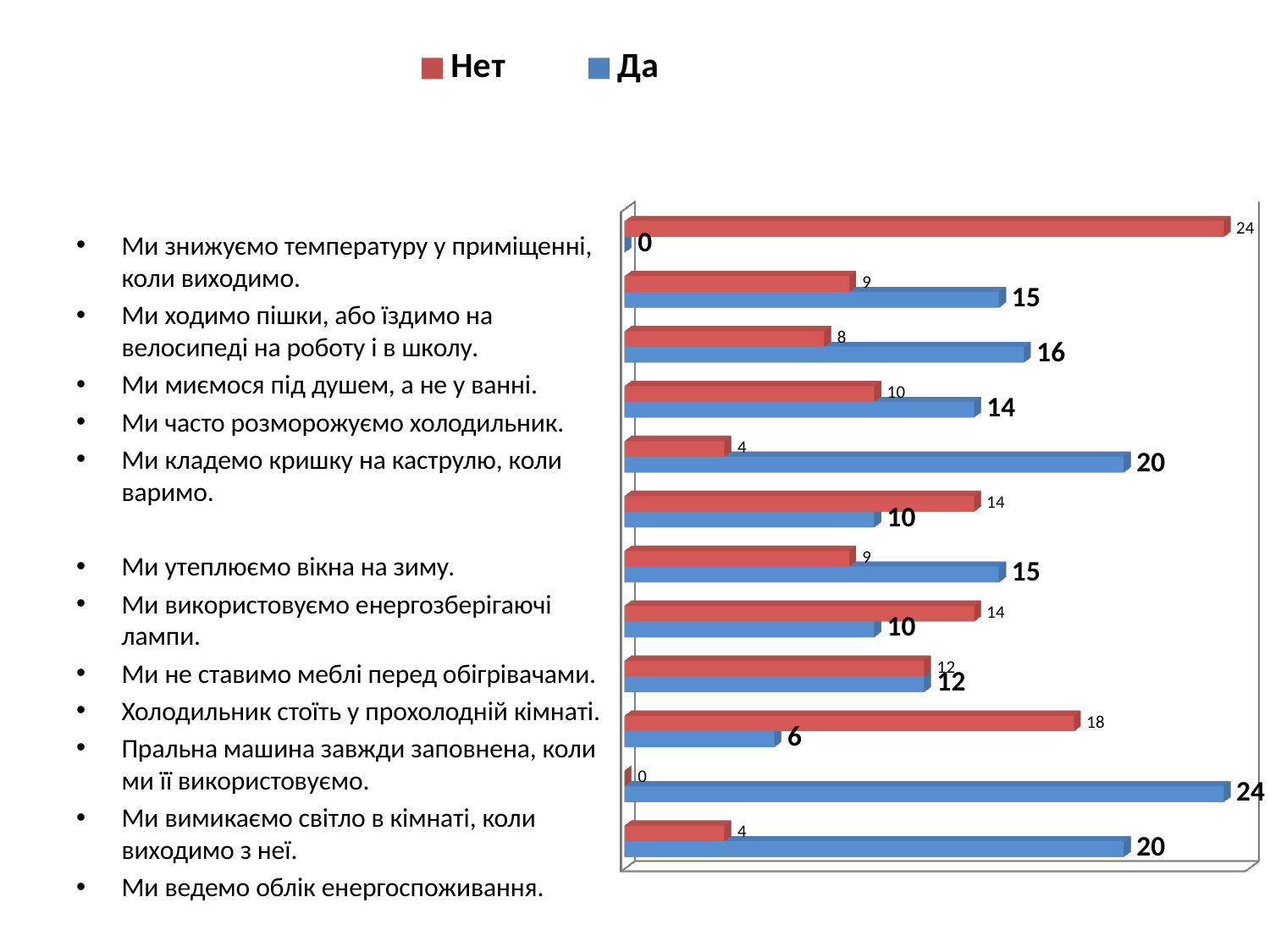
What is the value of the blue 'Да' bar in the topmost pair of bars? 0 How many pairs of bars (categories) are plotted in the chart? 12 Which colour represents the 'Нет' series in the legend? red What is the lowest value among the blue 'Да' bars? 0 What is the value of the blue 'Да' bar in the bottommost pair of bars? 20 How many series does the legend list? 2 What kind of chart is shown on the slide? bar chart What is the value of the red 'Нет' bar in the topmost pair of bars? 24 In the bottommost pair of bars, what is the difference between the 'Да' value and the 'Нет' value? 16 What is the highest value among the blue 'Да' bars? 24 What is the combined total of the 'Да' and 'Нет' values in the bottommost pair of bars? 24 In the bottommost pair of bars, which is larger, 'Да' or 'Нет'? Да